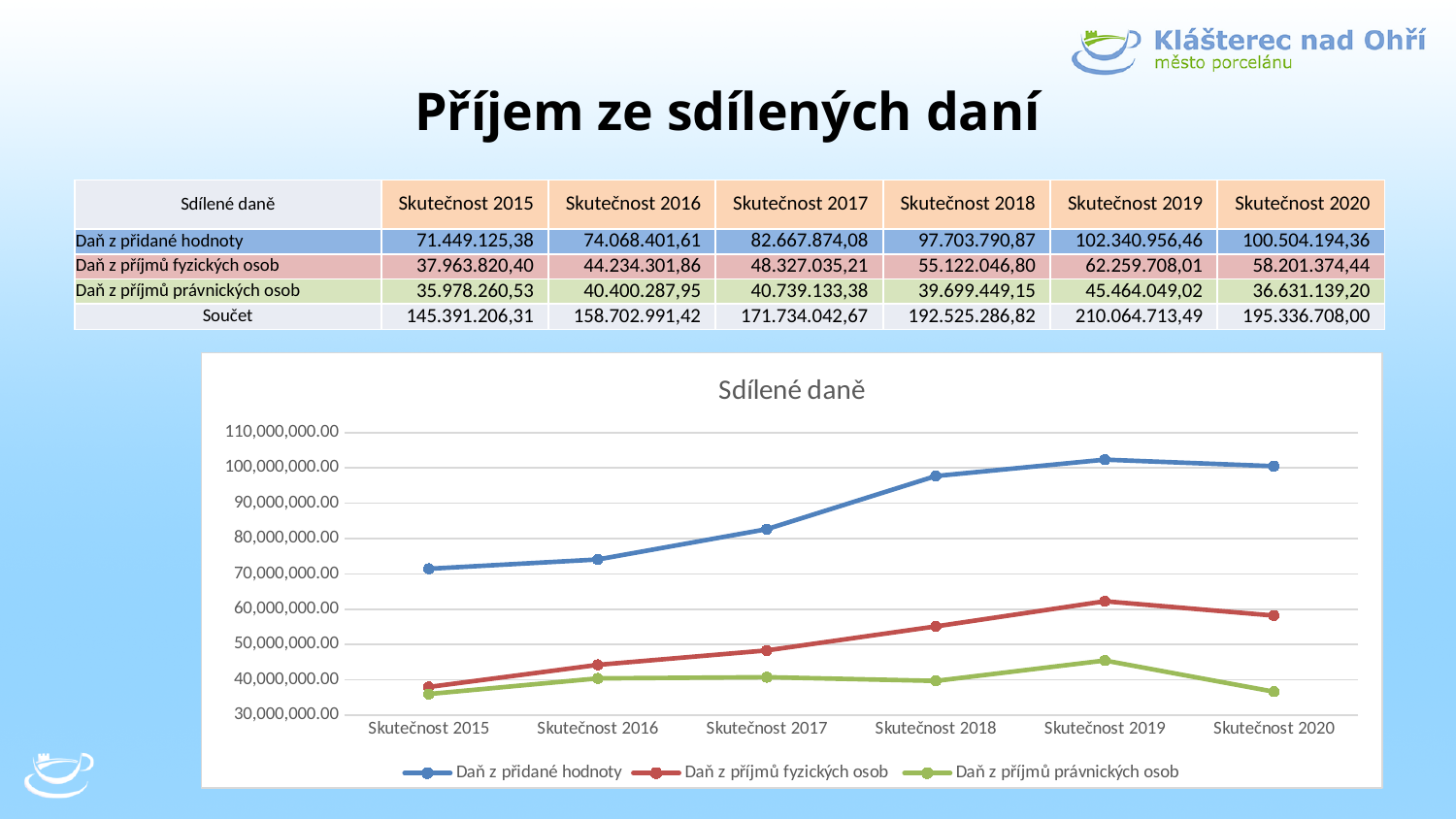
Is the value for Daň z příjmů fyzických osob in Skutečnost 2015 greater or less than 40,000,000.00? less Does the Daň z přidané hodnoty line rise or fall from Skutečnost 2015 to Skutečnost 2019? rises What is the title of the chart? Sdílené daně How many points are plotted along the x axis for each series? 6 In which year does Daň z přidané hodnoty reach its highest value? Skutečnost 2019 How many series does the chart legend list? 3 What is the value of Daň z přidané hodnoty for Skutečnost 2019? 102.340.956,46 Is the value for Daň z přidané hodnoty in Skutečnost 2018 greater or less than 90,000,000.00? greater In which year does Daň z příjmů právnických osob reach its highest value? Skutečnost 2019 What is the difference between Daň z přidané hodnoty in Skutečnost 2019 and Skutečnost 2020? 1.836.762,10 What kind of chart is shown on the slide? line chart In Skutečnost 2017, which is larger: Daň z příjmů fyzických osob or Daň z příjmů právnických osob? Daň z příjmů fyzických osob